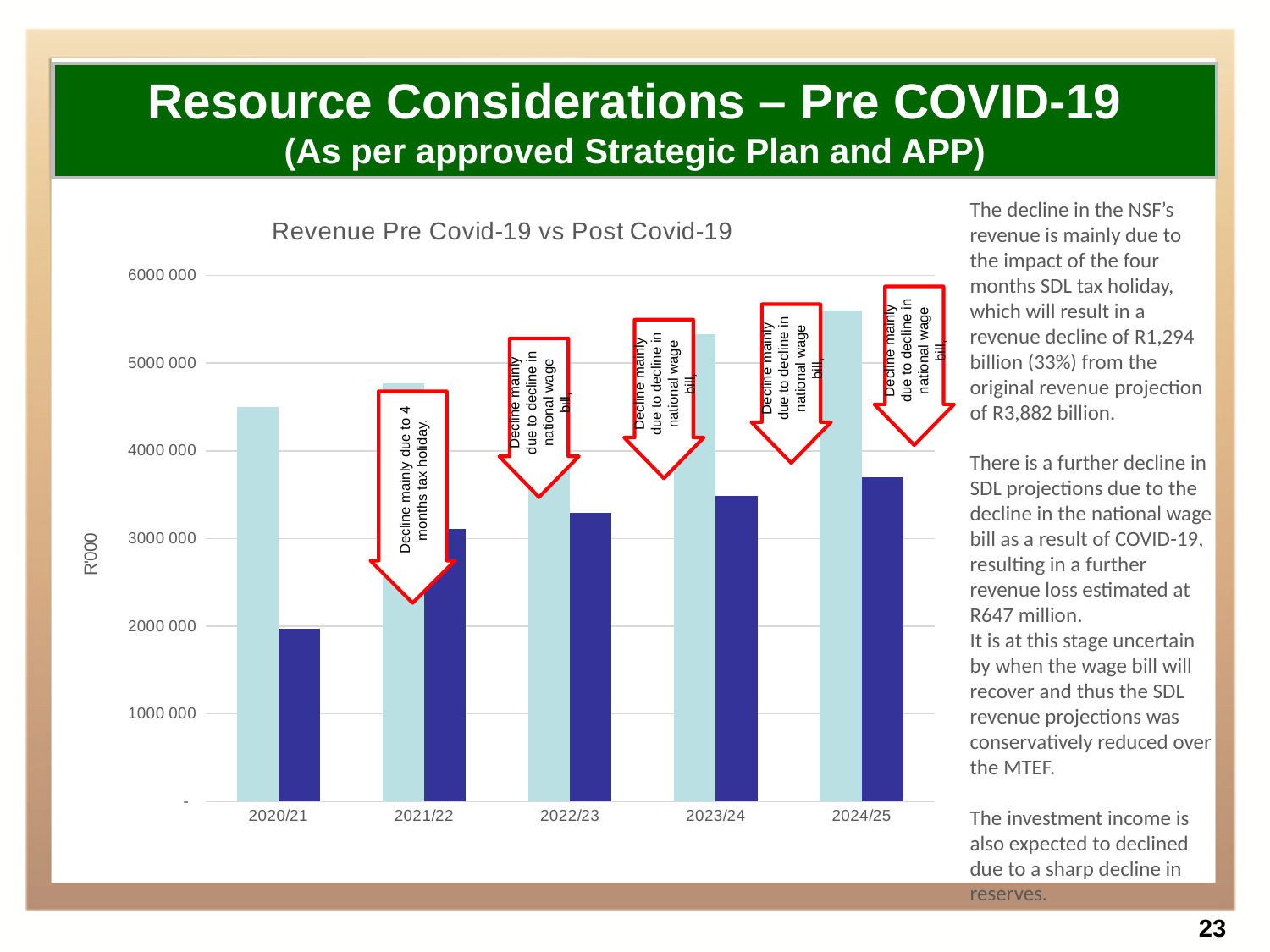
What is the title of the chart? Revenue Pre Covid-19 vs Post Covid-19 In 2020/21, which bar is taller, the light blue bar or the dark blue bar? light blue bar Do the dark blue bars rise or fall from 2020/21 to 2024/25? rise Which financial year has the shortest dark blue bar? 2020/21 Is the light blue bar for 2020/21 greater or less than 4000 000? greater Which financial year has the tallest light blue bar? 2024/25 How many financial years are shown on the x axis of the chart? 5 What type of chart is shown on the slide? bar chart Is the light blue bar for 2024/25 greater or less than 5000 000? greater What is the label on the vertical axis of the chart? R'000 Is the dark blue bar for 2021/22 greater or less than 3000 000? greater